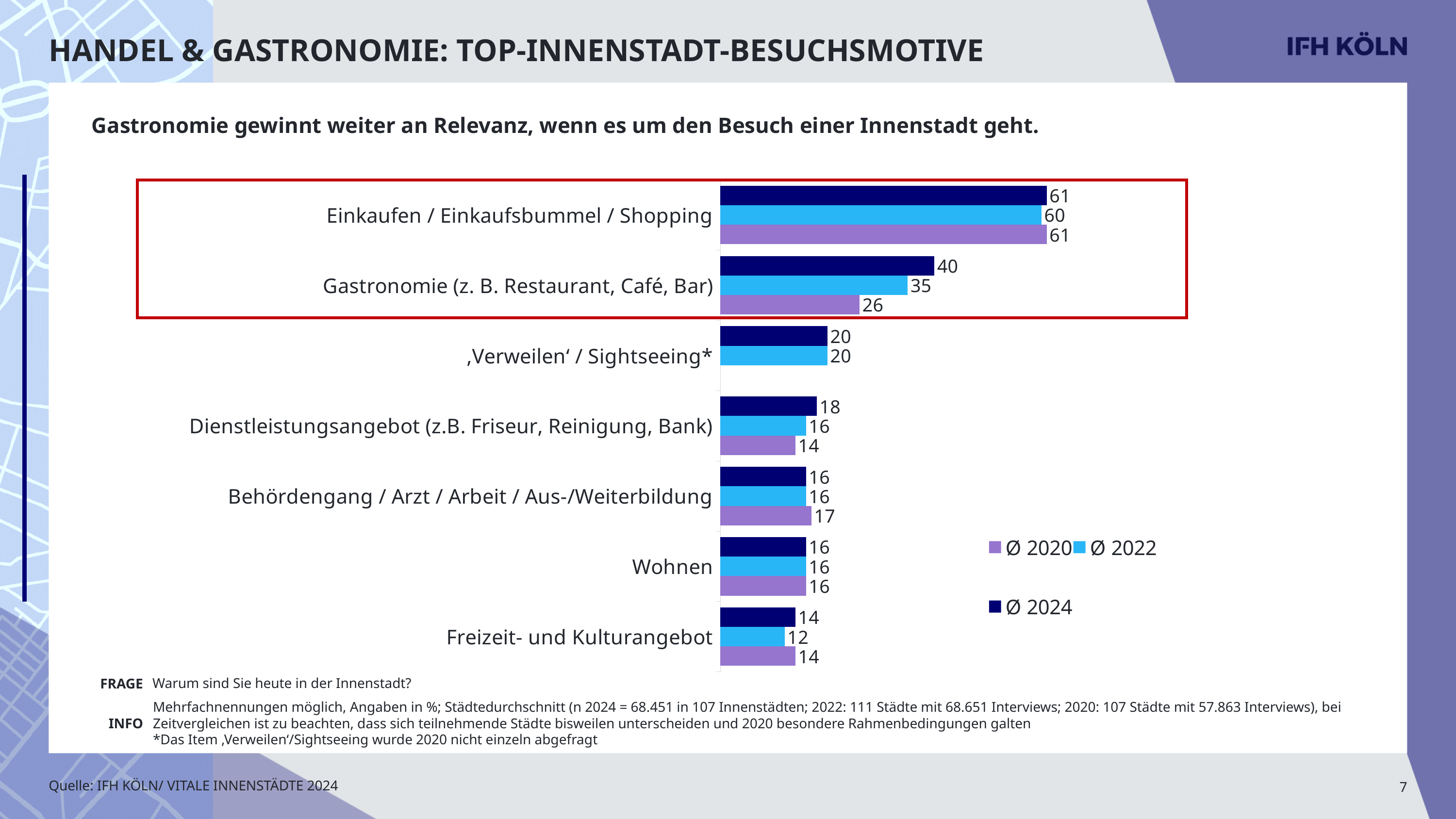
Which category has the lowest Ø 2022 value? Freizeit- und Kulturangebot What is the Ø 2022 value for Einkaufen / Einkaufsbummel / Shopping? 60 What is the Ø 2024 value for Gastronomie (z. B. Restaurant, Café, Bar)? 40 What is the Ø 2022 value for Freizeit- und Kulturangebot? 12 Which category has the highest Ø 2024 value? Einkaufen / Einkaufsbummel / Shopping What kind of chart is shown on the slide? Bar chart What is the difference between the Ø 2024 and Ø 2020 values for Gastronomie (z. B. Restaurant, Café, Bar)? 14 Which is larger for Dienstleistungsangebot (z.B. Friseur, Reinigung, Bank): the Ø 2024 value or the Ø 2020 value? Ø 2024 How many series does the legend list? 3 Which category has no Ø 2020 bar? ‚Verweilen' / Sightseeing* How many categories are shown in the chart? 7 What is the Ø 2020 value for Gastronomie (z. B. Restaurant, Café, Bar)? 26